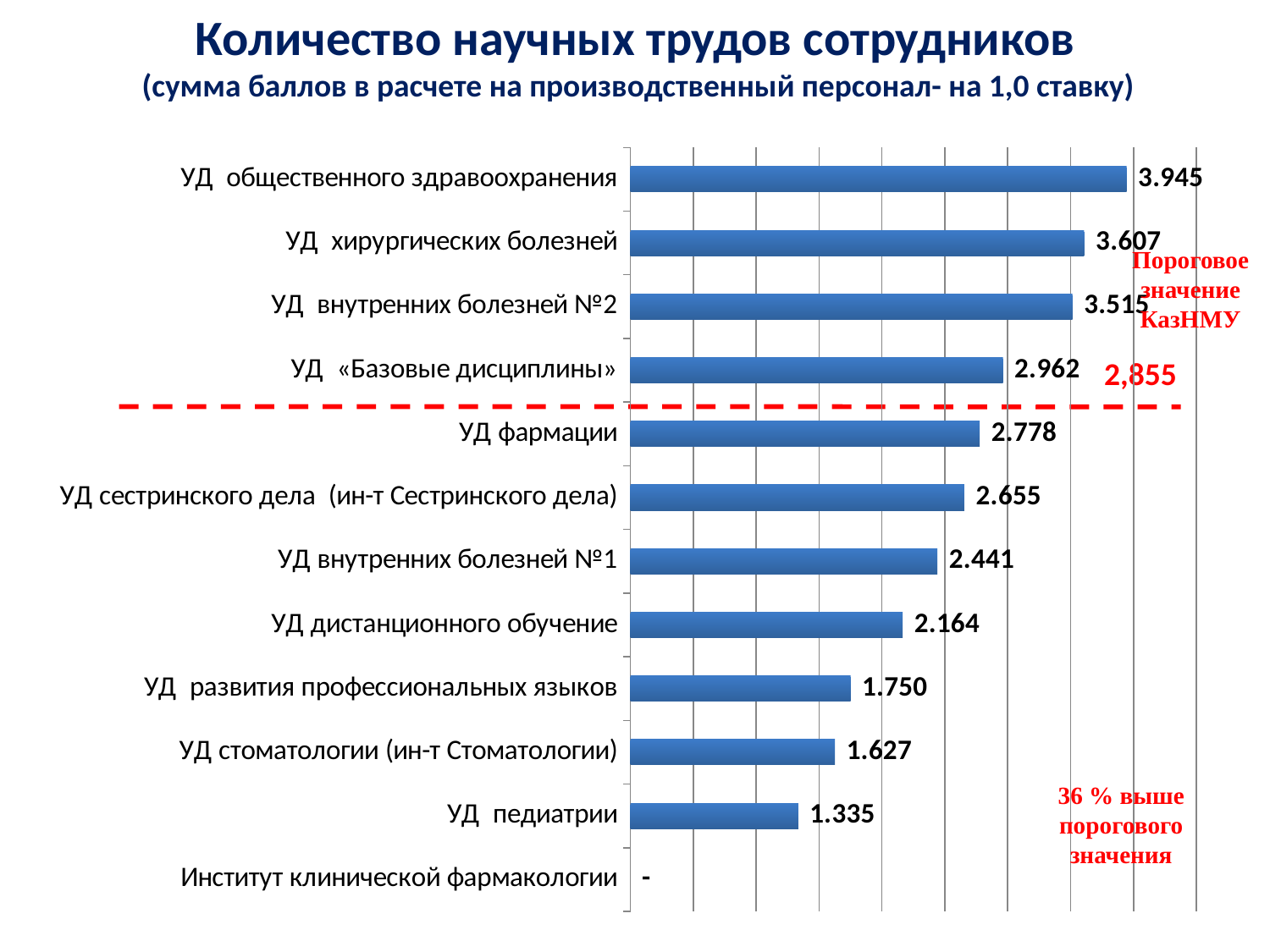
What is the value for УД дистанционного обучение? 2.164 Which is larger, the value for УД стоматологии (ин-т Стоматологии) or the value for УД развития профессиональных языков? УД развития профессиональных языков Which category has the highest value? УД общественного здравоохранения How many categories are listed on the chart? 12 What is the value for УД педиатрии? 1.335 What is the value for УД фармации? 2.778 What value is shown for Институт клинической фармакологии? - What kind of chart is shown on the slide? Bar chart Which category has the shortest bar among those with a plotted value? УД педиатрии What is the value for УД общественного здравоохранения? 3.945 What is the difference between the values for УД общественного здравоохранения and УД хирургических болезней? 0.338 What threshold value (Пороговое значение КазНМУ) is marked on the chart? 2,855